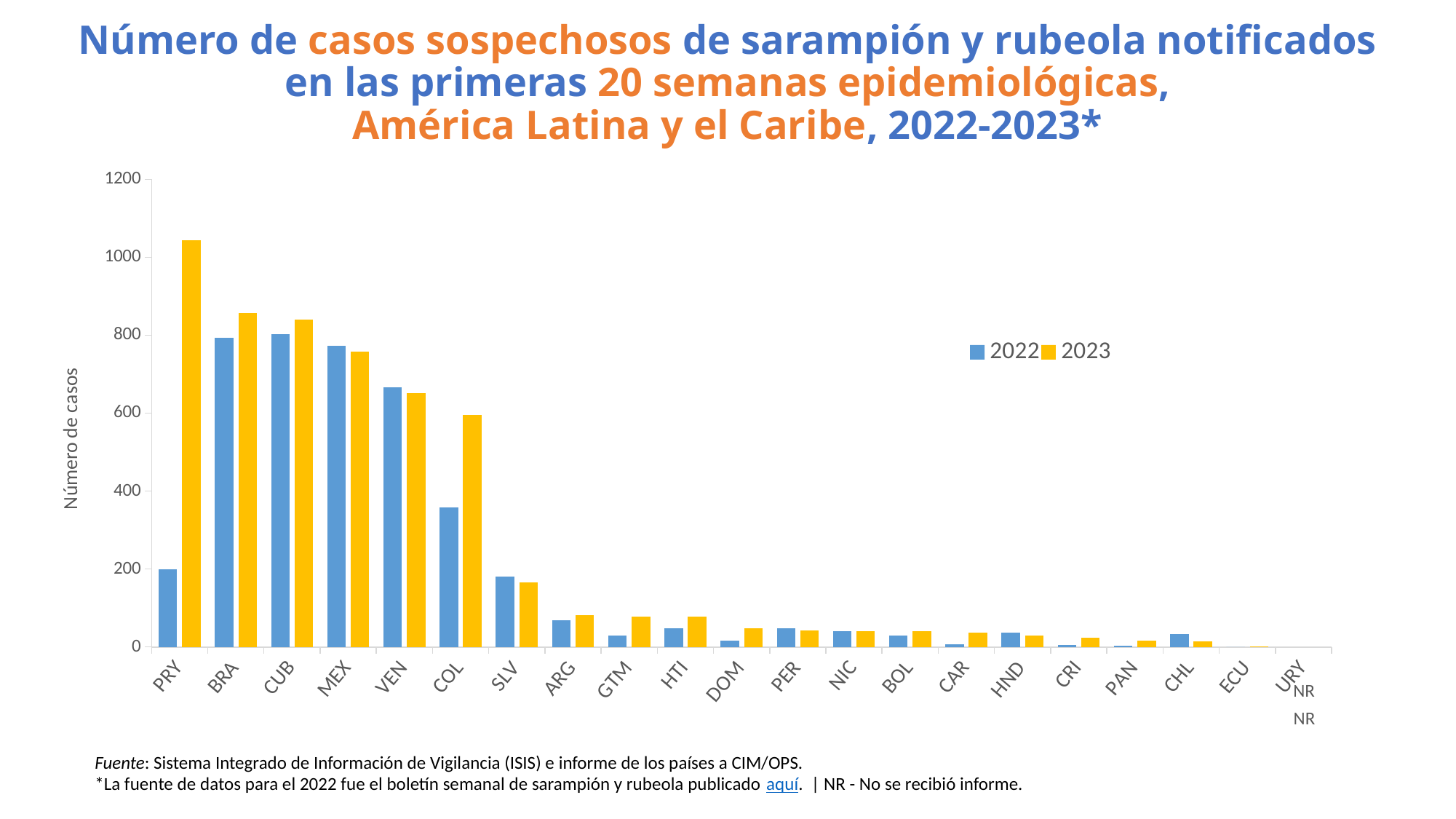
Do the values generally rise or fall moving from left to right along the x axis? fall How many series does the legend list? 2 For COL, which series has the larger value, 2022 or 2023? 2023 How many countries are shown on the x axis? 21 What kind of chart is shown on the slide? bar chart Is the 2022 value for COL greater or less than 400? less Is the 2022 value for VEN greater or less than 600? greater What is the label of the y axis? Número de casos Which country has the highest value for 2023? PRY For PRY, which series has the larger value, 2022 or 2023? 2023 Is the 2023 value for BRA greater or less than 800? greater